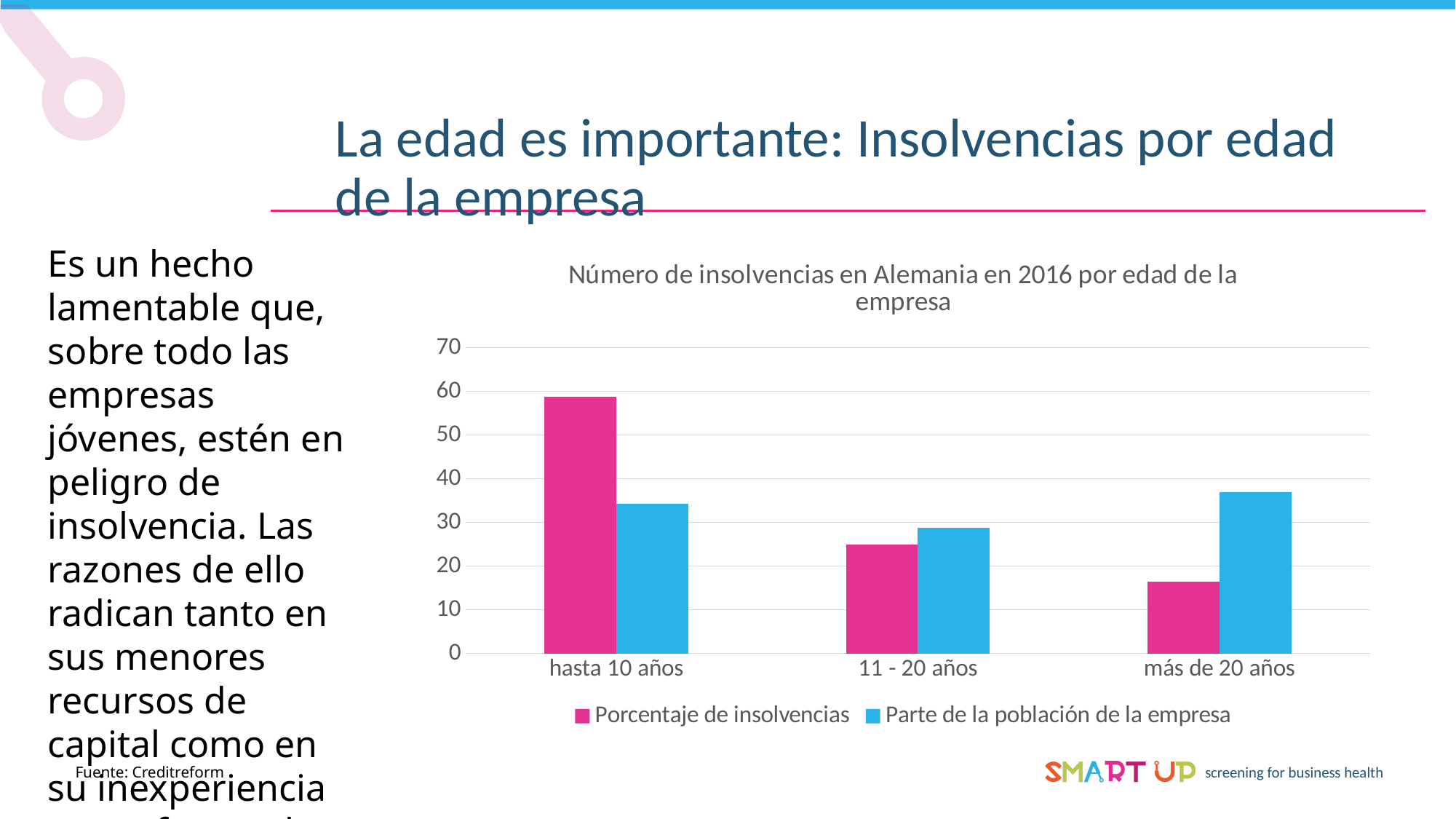
Which age category has the highest value for Porcentaje de insolvencias? hasta 10 años Which age category has the lowest value for Porcentaje de insolvencias? más de 20 años For más de 20 años, which is larger: Porcentaje de insolvencias or Parte de la población de la empresa? Parte de la población de la empresa For hasta 10 años, which is larger: Porcentaje de insolvencias or Parte de la población de la empresa? Porcentaje de insolvencias Is the value for Porcentaje de insolvencias for hasta 10 años greater or less than 50? greater Do the values for Porcentaje de insolvencias rise or fall across the age categories from left to right? fall How many age categories are shown on the x axis of the chart? 3 Which age category has the lowest value for Parte de la población de la empresa? 11 - 20 años What is the title of the chart? Número de insolvencias en Alemania en 2016 por edad de la empresa What kind of chart is shown on the slide? bar chart Which age category has the highest value for Parte de la población de la empresa? más de 20 años How many series does the chart legend list? 2